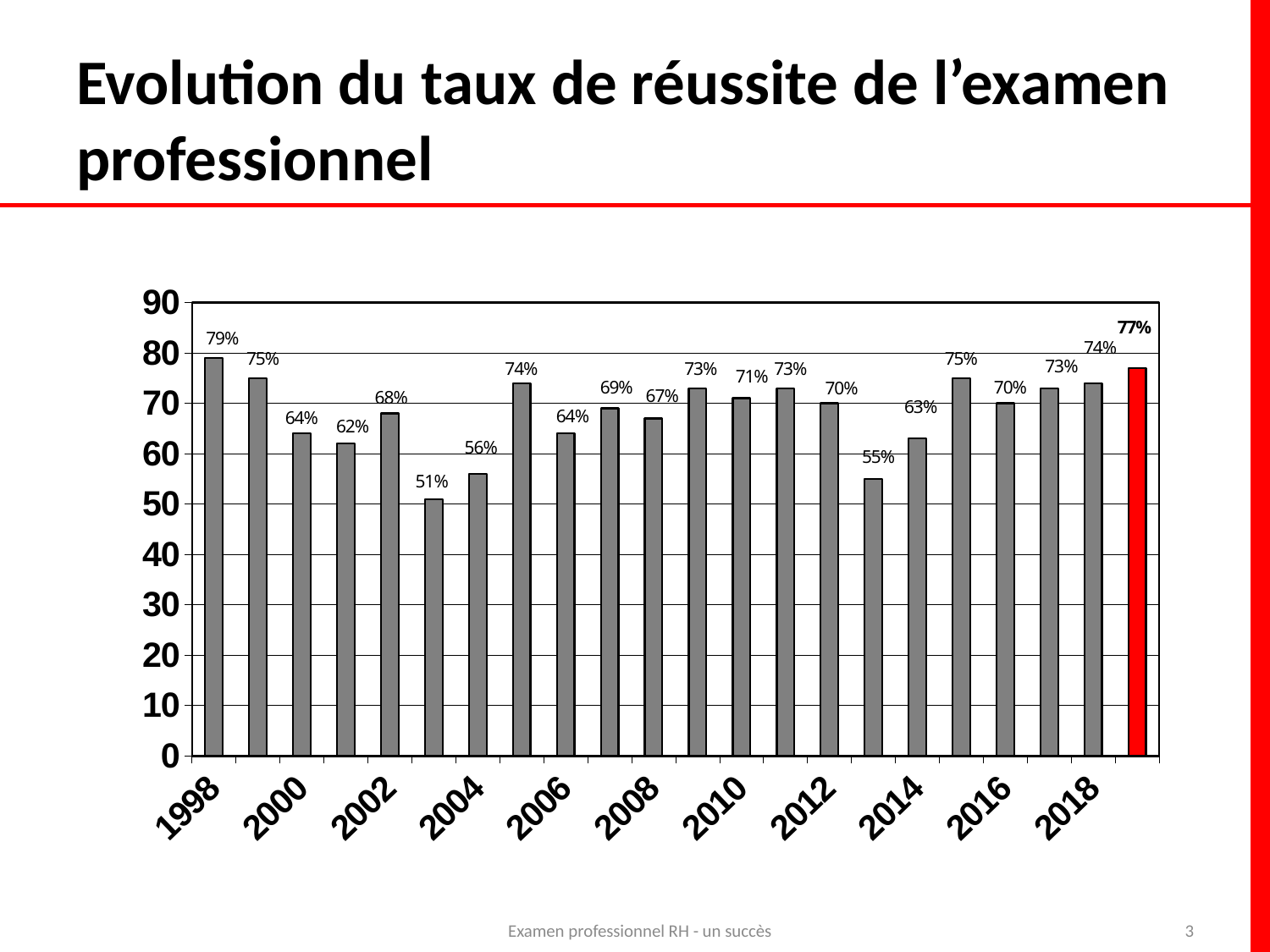
What is the difference between the success rate in 1998 and in 2000? 15% How many bars are plotted in the chart? 22 What type of chart is shown on the slide? bar chart What is the success rate shown for 2000? 64% What value is shown on the red bar at the right end of the chart? 77% Which is larger, the value for 2004 or the value for 2006? 2006 Is the value for 2012 greater or less than 60? greater What is the success rate shown for 1998? 79% What is the success rate shown for 2014? 63% Which year has the highest success rate in the chart? 1998 What is the lowest value shown in the chart? 51% What is the success rate shown for 2002? 68%